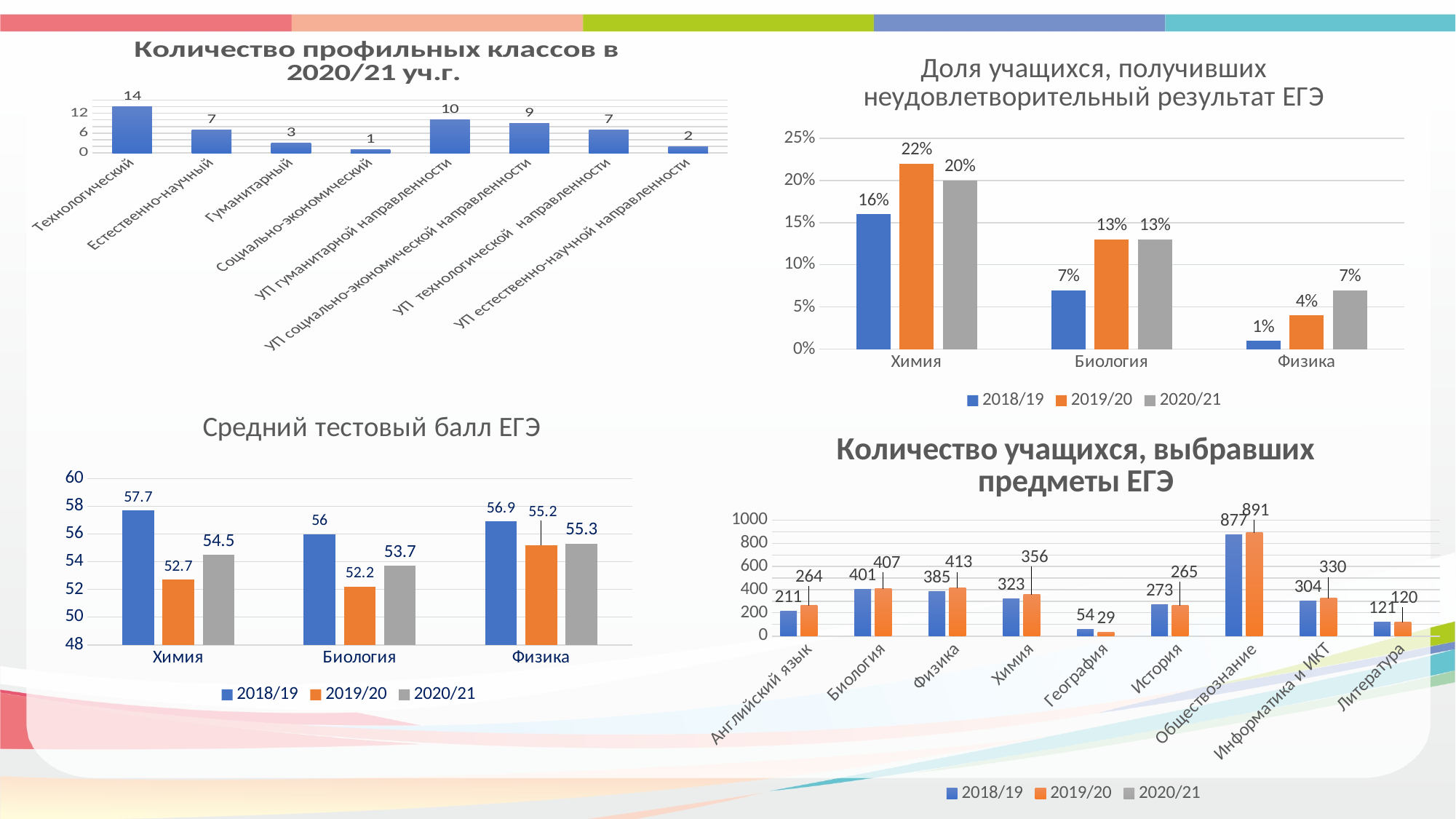
In the chart 'Средний тестовый балл ЕГЭ', which subject has the highest 2018/19 value? Химия In the chart 'Доля учащихся, получивших неудовлетворительный результат ЕГЭ', what is the value for Химия in 2019/20? 22% What type of chart is 'Количество учащихся, выбравших предметы ЕГЭ'? Bar chart In the chart 'Доля учащихся, получивших неудовлетворительный результат ЕГЭ', what is the difference between the 2020/21 and 2018/19 values for Физика? 6% In the chart 'Количество учащихся, выбравших предметы ЕГЭ', what is the difference between the 2019/20 and 2018/19 values for Английский язык? 53 In the chart 'Количество учащихся, выбравших предметы ЕГЭ', what is the value for Обществознание in 2019/20? 891 In the chart 'Количество профильных классов в 2020/21 уч.г.', which category has the lowest value? Социально-экономический How many categories are shown in the chart 'Количество профильных классов в 2020/21 уч.г.'? 8 In the chart 'Количество профильных классов в 2020/21 уч.г.', how many classes are shown for Технологический? 14 In the chart 'Средний тестовый балл ЕГЭ', what is the value for Биология in 2020/21? 53.7 In the chart 'Средний тестовый балл ЕГЭ', which is larger for Физика: the 2019/20 value or the 2018/19 value? 2018/19 How many series does the legend list in the chart 'Доля учащихся, получивших неудовлетворительный результат ЕГЭ'? 3